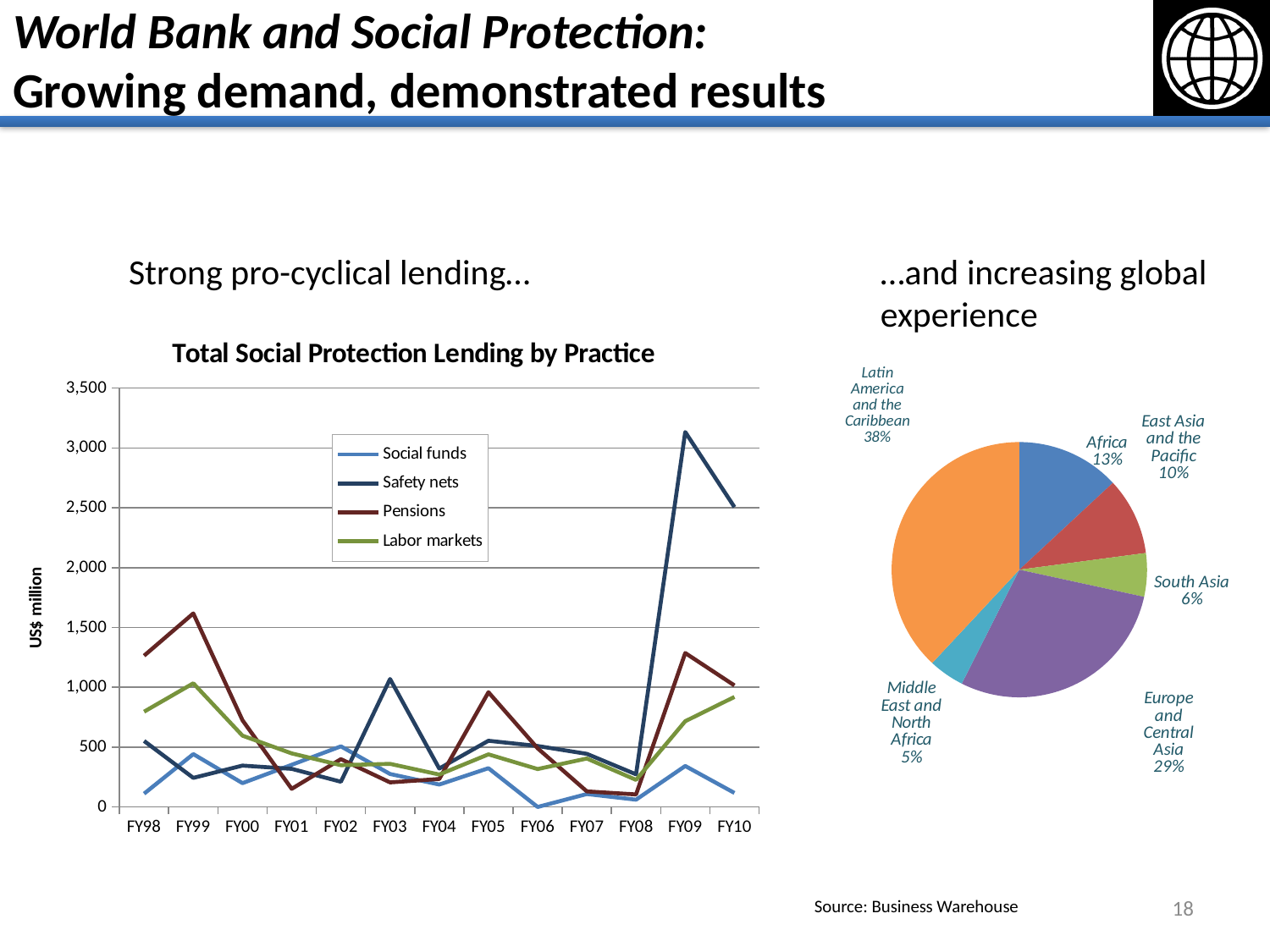
In the 'Total Social Protection Lending by Practice' chart, what is the label on the vertical axis? US$ million In the 'Total Social Protection Lending by Practice' chart, which series has the lowest value in FY06? Social funds In the 'Total Social Protection Lending by Practice' chart, how many fiscal years are shown on the x axis? 13 In the pie chart on the right, what share does Latin America and the Caribbean have? 38% In the pie chart on the right, what is the difference between the shares of Europe and Central Asia and Africa? 16% What kind of chart is 'Total Social Protection Lending by Practice'? Line chart In the pie chart on the right, how many regions are shown? 6 In the 'Total Social Protection Lending by Practice' chart, is the value for Safety nets in FY09 greater or less than 3,000? greater In the 'Total Social Protection Lending by Practice' chart, which series has the highest value in FY09? Safety nets In the pie chart on the right, which region has the smallest share? Middle East and North Africa In the 'Total Social Protection Lending by Practice' chart, is the value for Pensions in FY99 greater or less than 1,500? greater In the 'Total Social Protection Lending by Practice' chart, how many series does the legend list? 4